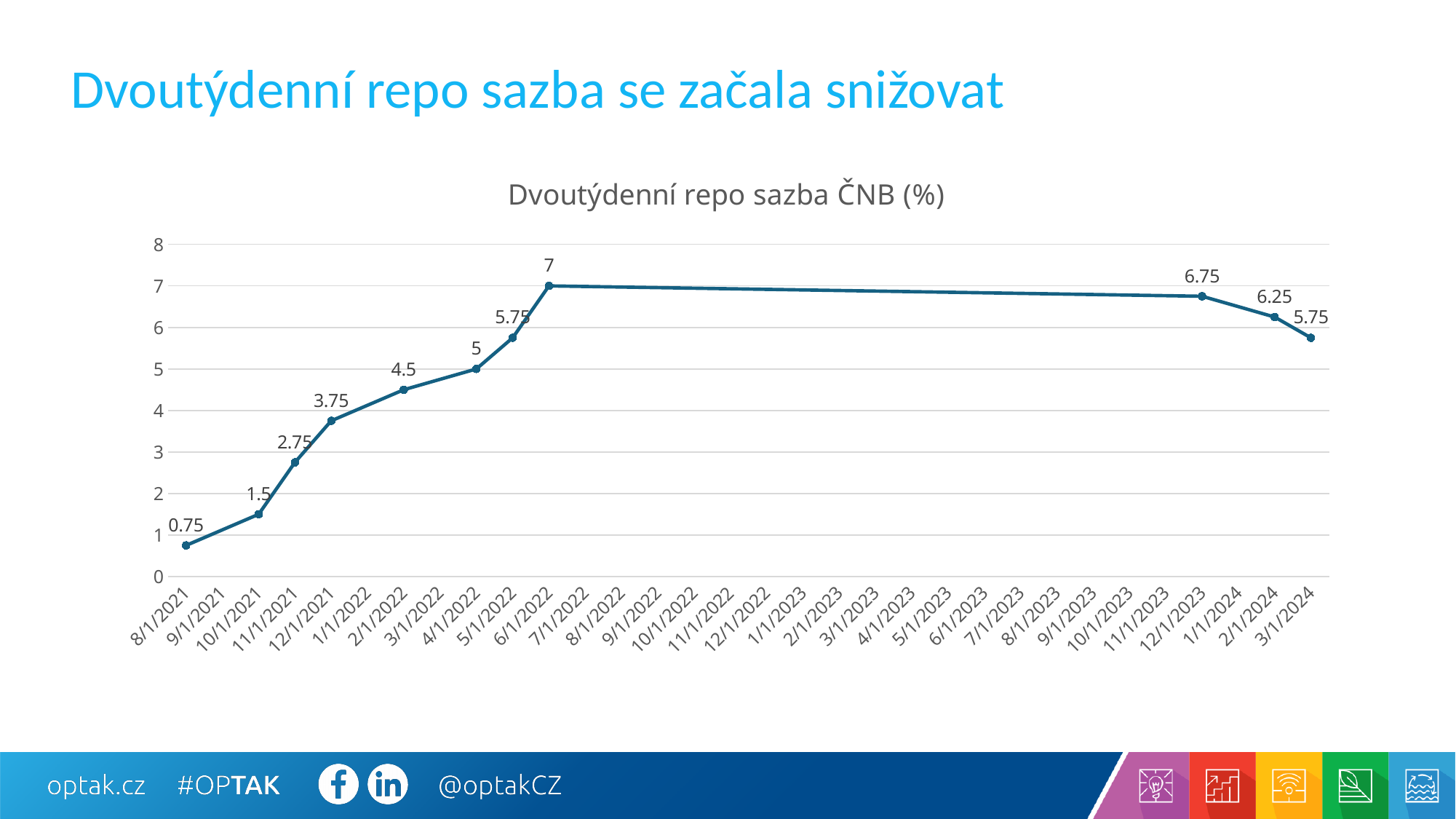
What is the value of the data point at 12/1/2023? 6.75 What type of chart is shown on the slide? line chart Which is larger, the value at 12/1/2023 or the value at 2/1/2024? 12/1/2023 What is the title of the chart? Dvoutýdenní repo sazba ČNB (%) What is the value of the data point at 8/1/2021? 0.75 How many labelled data points are plotted on the line? 11 What is the value of the data point at 3/1/2024? 5.75 Does the line rise or fall between 8/1/2021 and 6/1/2022? rise What is the difference between the value at 6/1/2022 and the value at 3/1/2024? 1.25 What is the value of the data point at 6/1/2022? 7 What is the lowest value plotted on the chart? 0.75 What is the highest value plotted on the chart? 7